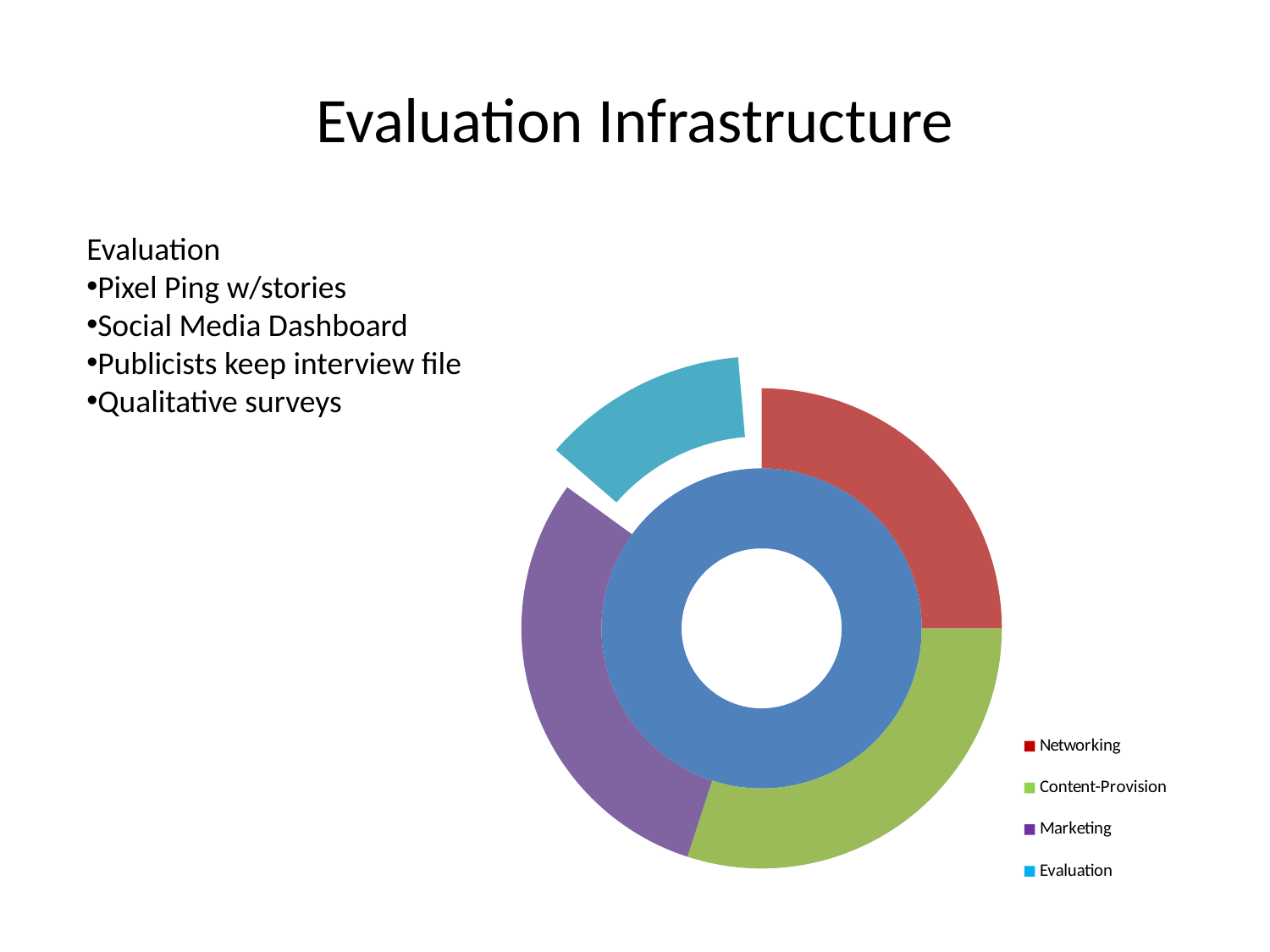
What kind of chart is shown on the slide? Doughnut (pie) chart Which slice is larger, Content-Provision or Evaluation? Content-Provision How many categories does the chart's legend list? 4 What are the four categories listed in the chart's legend? Networking, Content-Provision, Marketing, Evaluation Which category's slice is pulled out (exploded) from the ring? Evaluation Which slice is larger, Marketing or Evaluation? Marketing Which category has the smallest slice in the chart? Evaluation What colour represents Networking in the chart? Red Which slice is larger, Networking or Evaluation? Networking